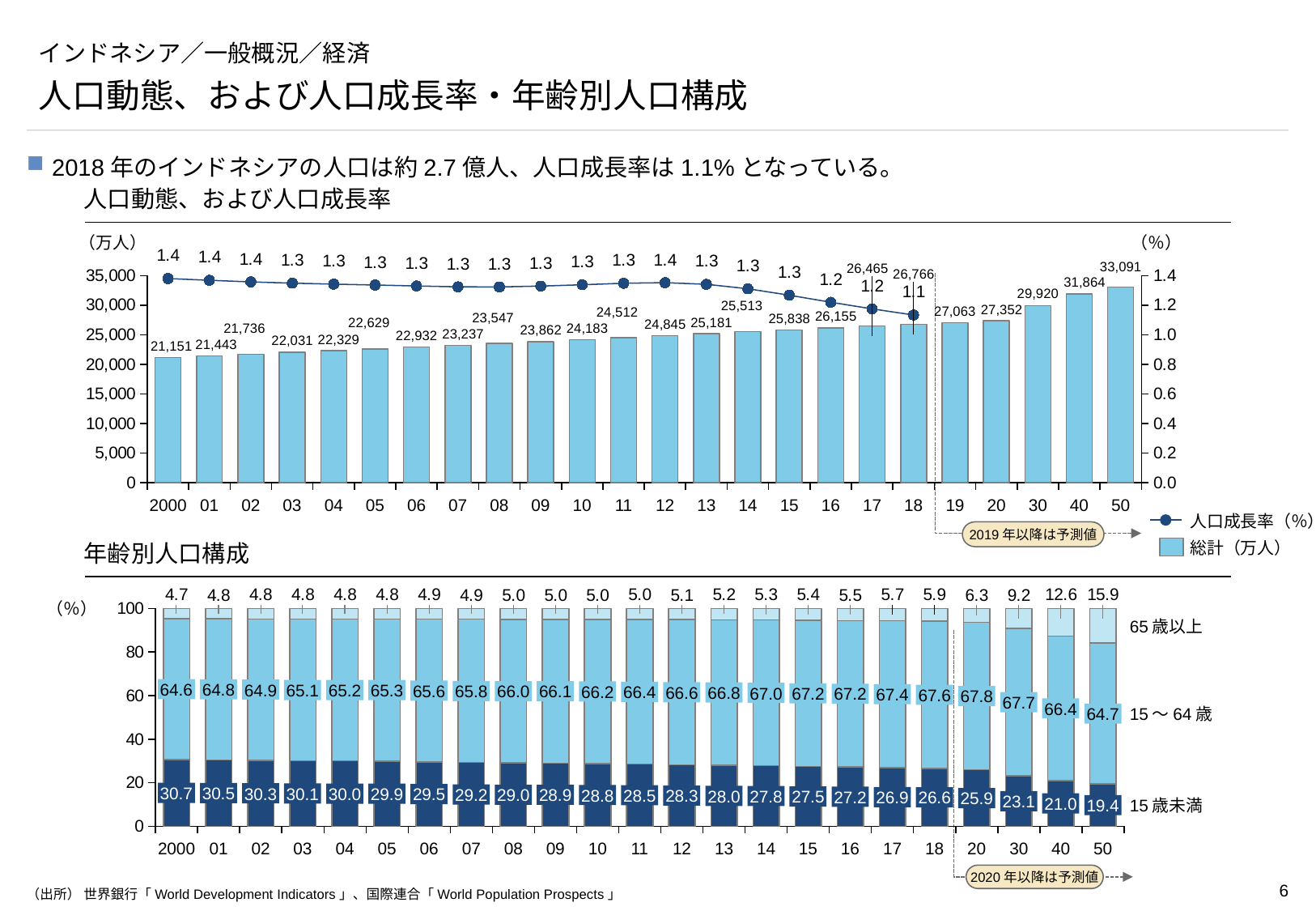
In the bottom chart (年齢別人口構成), what is the 15歳未満 share labelled for 2000? 30.7 How many bars (years) are shown in the bottom chart (年齢別人口構成)? 23 In the top chart (人口動態、および人口成長率), what is the 総計 value labelled for 2018? 26,766 In the top chart (人口動態、および人口成長率), what is the 総計 value labelled for 50 (2050)? 33,091 In the top chart (人口動態、および人口成長率), does the 人口成長率 line generally rise or fall from 2000 to 2018? fall In the bottom chart (年齢別人口構成), what is the 65歳以上 share labelled for 50? 15.9 In the top chart (人口動態、および人口成長率), what is the difference between the 総計 values for 50 and 2000? 11,940 In the top chart (人口動態、および人口成長率), which year has the lowest 総計 bar? 2000 What kind of chart is the bottom chart (年齢別人口構成)? stacked bar chart In the top chart (人口動態、および人口成長率), what is the 人口成長率 value labelled for 2018? 1.1 In the bottom chart (年齢別人口構成), what is the difference between the 15～64歳 share for 18 and for 2000? 3.0 How many series does the legend of the top chart (人口動態、および人口成長率) list? 2